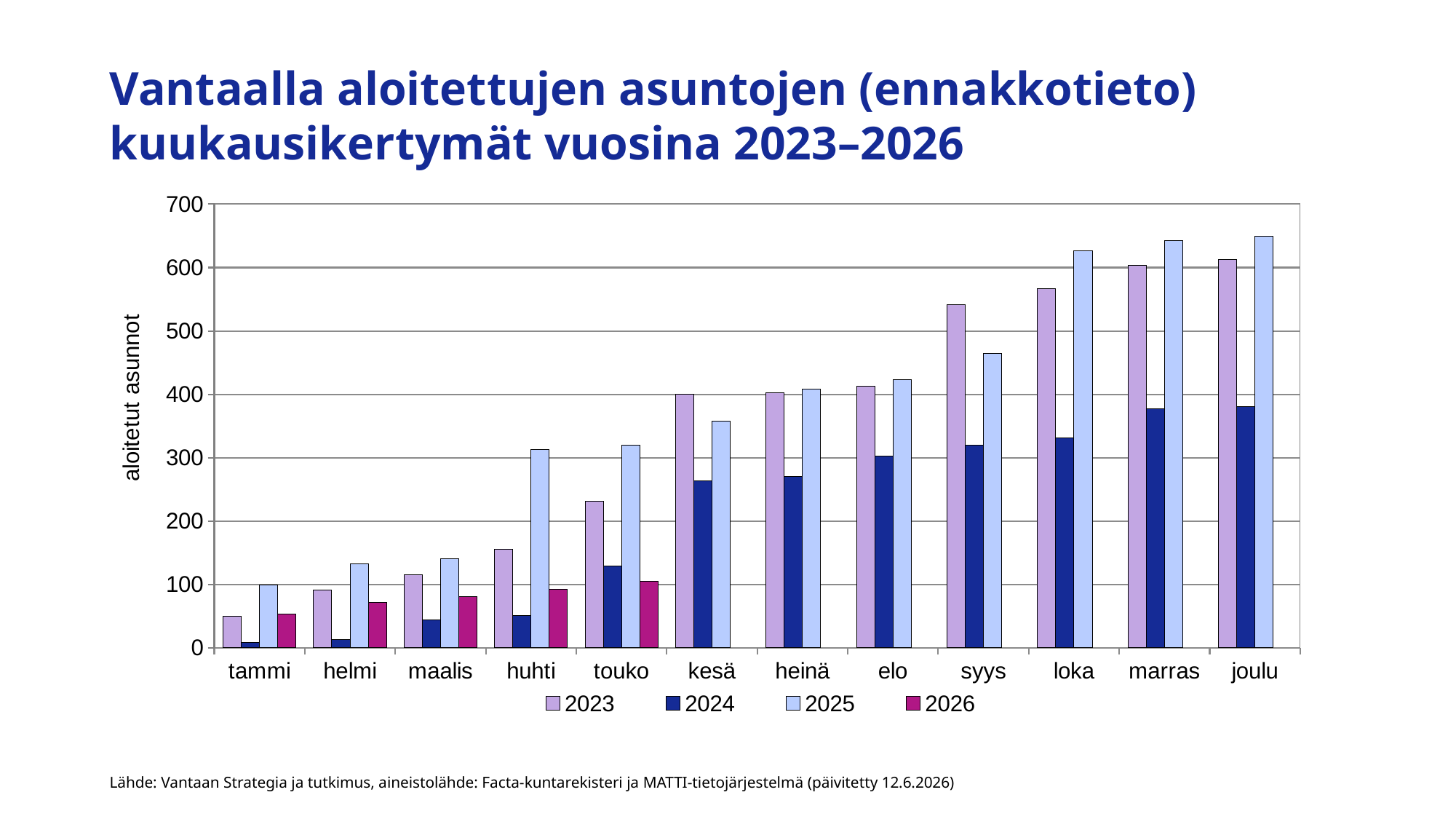
Which month has the lowest value for the 2023 series? tammi Is the value for 2025 in joulu greater or less than 600? greater How many months are shown on the x axis? 12 What kind of chart is shown on the slide? bar chart In kesä, which is larger: the value for 2023 or the value for 2025? 2023 For how many months does the 2026 series have a bar? 5 Is the value for 2024 in tammi greater or less than 100? less What is the label on the y axis? aloitetut asunnot Which series has the highest value in joulu? 2025 How many series does the legend list? 4 Do the values for the 2025 series rise or fall from tammi to joulu? rise Is the value for 2023 in touko greater or less than 300? less